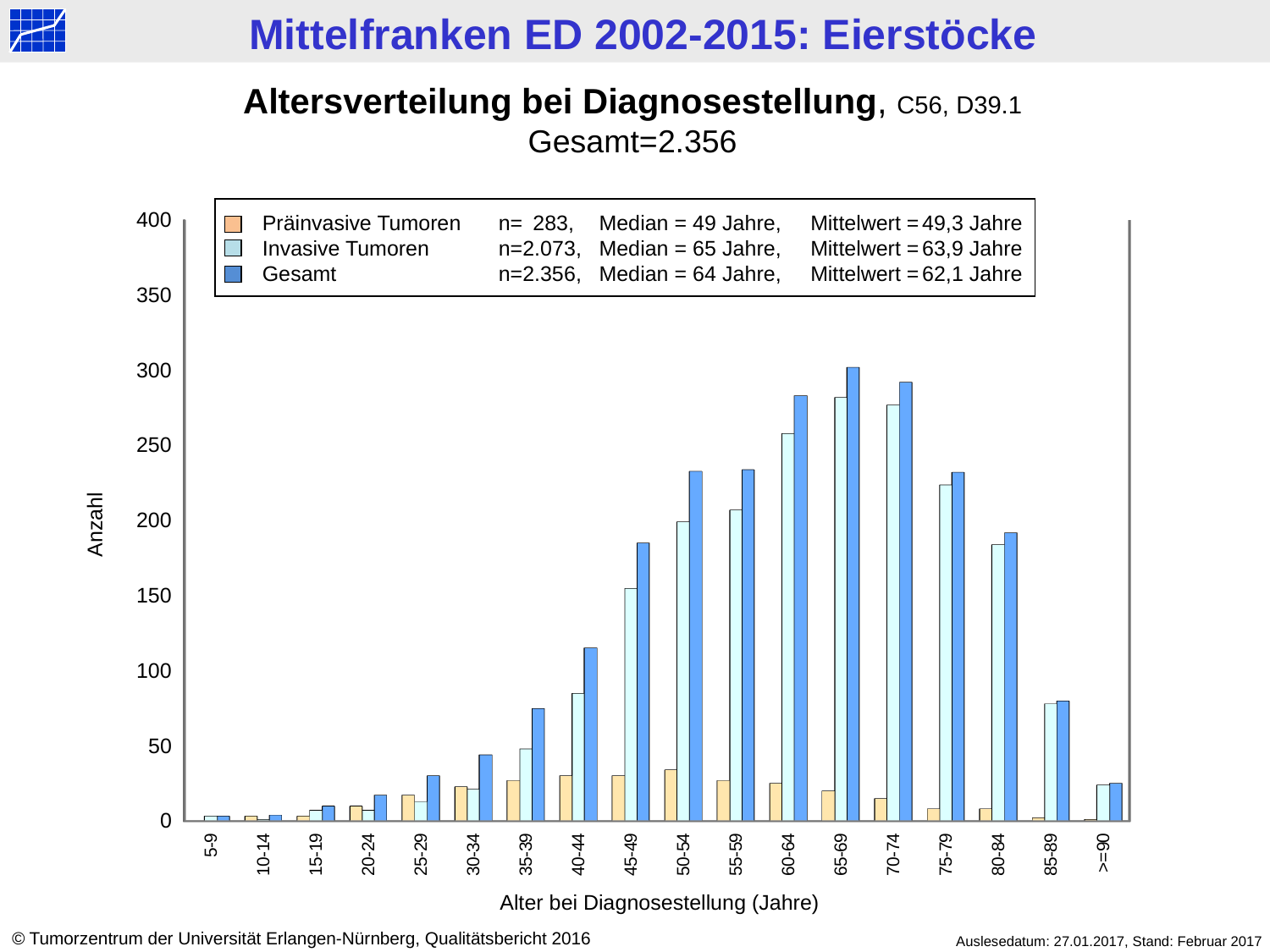
Is the Invasive Tumoren value for the 75-79 age group greater or less than 200? greater How many series does the legend list? 3 Is the Gesamt value for the 35-39 age group greater or less than 100? less Is the Gesamt value for the 65-69 age group greater or less than 250? greater Which is larger for the Gesamt series: the 60-64 age group or the 45-49 age group? 60-64 According to the legend, what is n for Präinvasive Tumoren? 283 What kind of chart is shown on the slide? bar chart What is the label of the y axis? Anzahl Do the Gesamt values rise or fall from the 65-69 age group to the >=90 age group? fall How many age categories are shown on the x axis? 18 Which age group has the highest value for the Gesamt series? 65-69